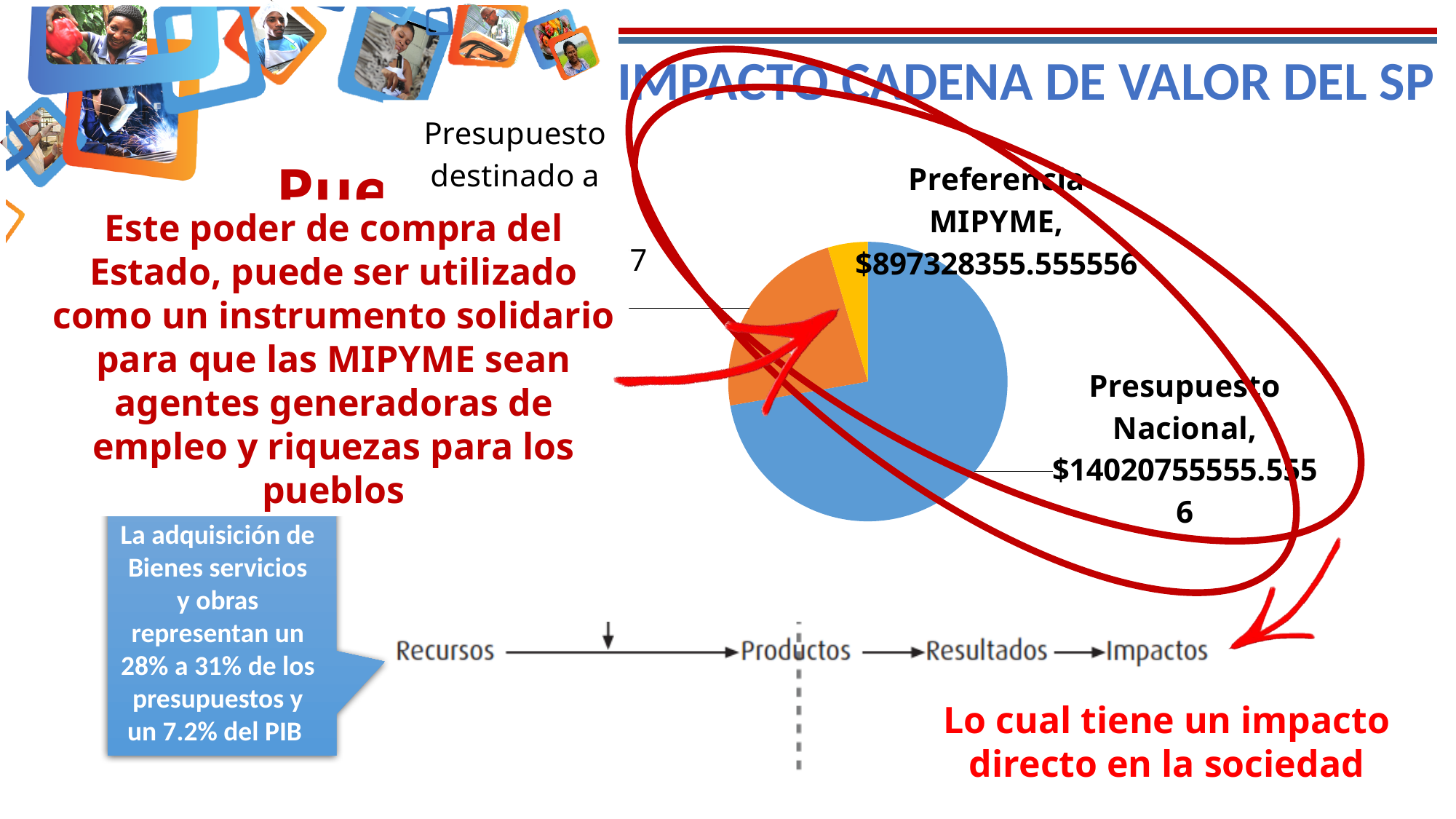
What colour is the Presupuesto Nacional slice in the pie chart? blue What kind of chart is shown on the slide? pie chart What colour is the Preferencia MIPYME slice in the pie chart? yellow Which slice of the pie chart is the smallest? Preferencia MIPYME Which is larger in the pie chart, Presupuesto Nacional or Preferencia MIPYME? Presupuesto Nacional Which slice of the pie chart is the largest? Presupuesto Nacional What is the value shown for Presupuesto Nacional in the pie chart? $14020755555.5556 How many slices does the pie chart have? 3 What is the value shown for Preferencia MIPYME in the pie chart? $897328355.555556